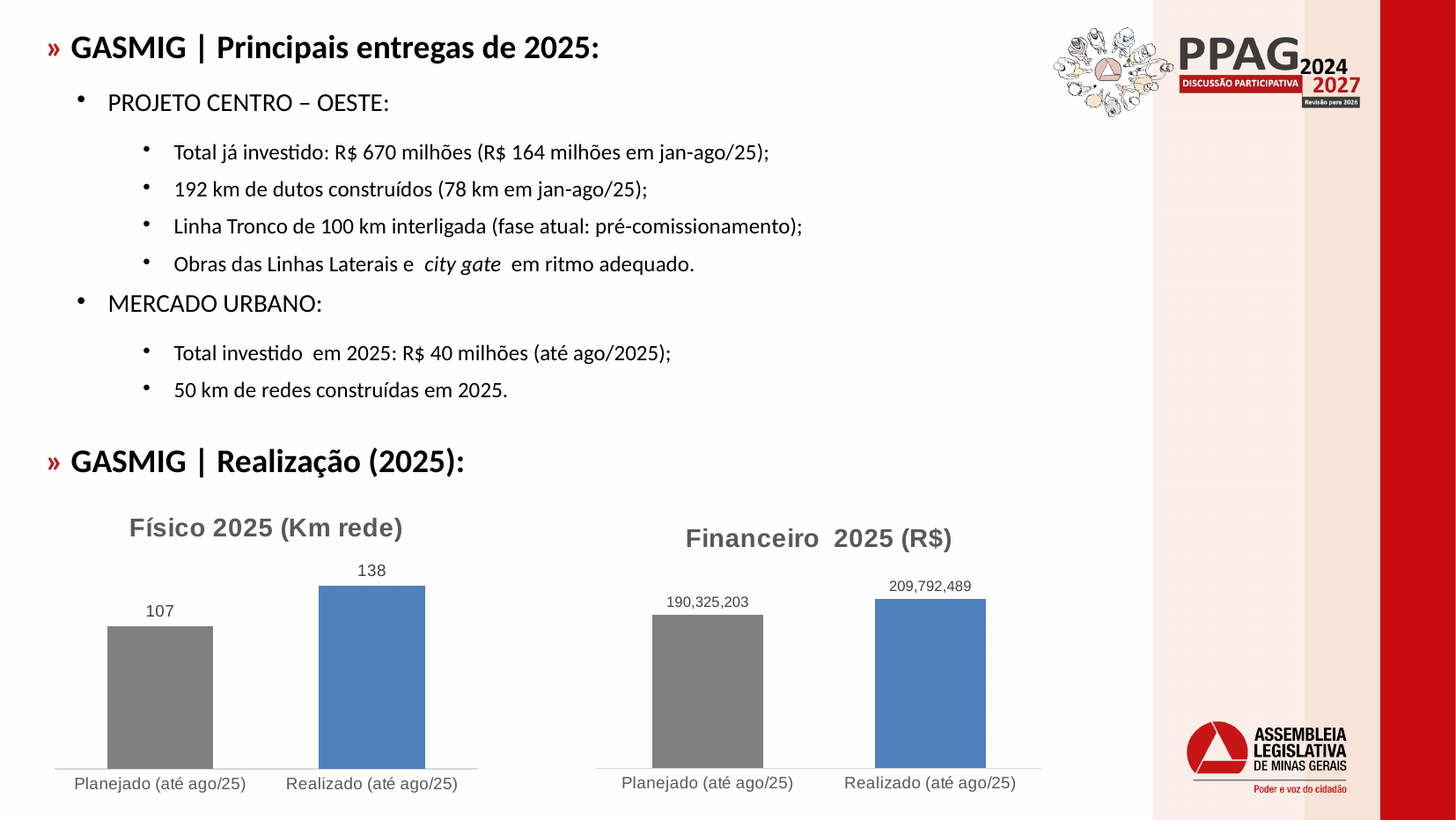
What kind of chart is the 'Financeiro 2025 (R$)' chart? Bar chart In the 'Físico 2025 (Km rede)' chart, which category has the highest value? Realizado (até ago/25) In the 'Físico 2025 (Km rede)' chart, what is the value for Planejado (até ago/25)? 107 How many categories are shown in the 'Físico 2025 (Km rede)' chart? 2 What is the title of the chart on the left side of the slide? Físico 2025 (Km rede) In the 'Financeiro 2025 (R$)' chart, what is the difference between Realizado (até ago/25) and Planejado (até ago/25)? 19,467,286 In the 'Financeiro 2025 (R$)' chart, which category has the lowest value? Planejado (até ago/25) In the 'Físico 2025 (Km rede)' chart, what is the value for Realizado (até ago/25)? 138 In the 'Financeiro 2025 (R$)' chart, what is the value for Planejado (até ago/25)? 190,325,203 In the 'Financeiro 2025 (R$)' chart, which is larger: Planejado (até ago/25) or Realizado (até ago/25)? Realizado (até ago/25) In the 'Financeiro 2025 (R$)' chart, what is the value for Realizado (até ago/25)? 209,792,489 In the 'Físico 2025 (Km rede)' chart, what is the difference between Realizado (até ago/25) and Planejado (até ago/25)? 31